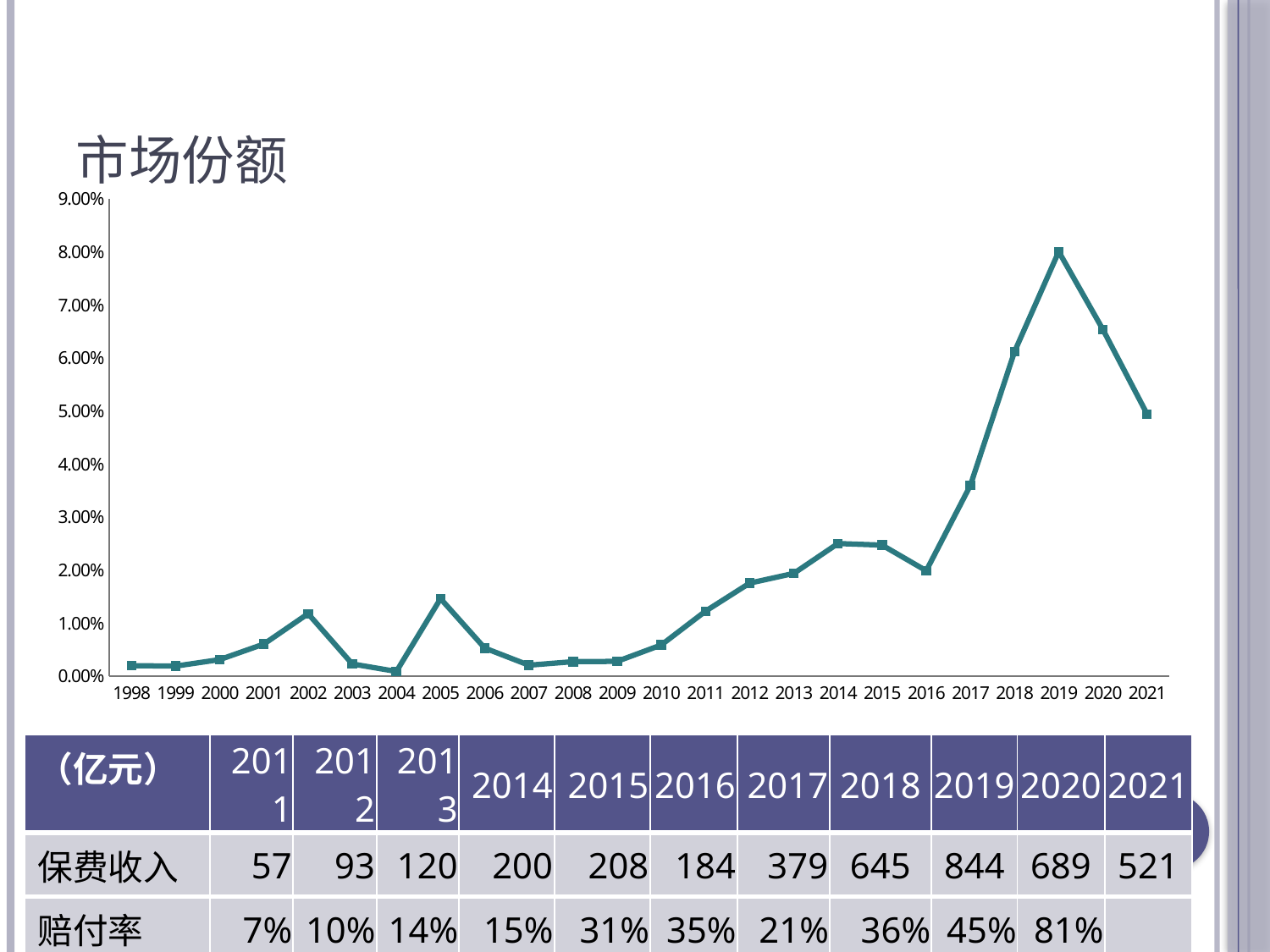
Is the value for 2016 greater or less than 3.00%? less Which year has the lowest market share in the chart? 2004 Is the value for 2021 greater or less than 4.00%? greater Which year has the highest market share in the chart? 2019 Is the value for 2019 greater or less than 7.00%? greater Which year has the larger market share, 2019 or 2020? 2019 What is the title of the chart? 市场份额 Does the market share rise or fall from 2016 to 2019? rise How many years are plotted on the x axis of the chart? 24 Which year has the larger market share, 2002 or 2005? 2005 What kind of chart is shown on the slide? line chart